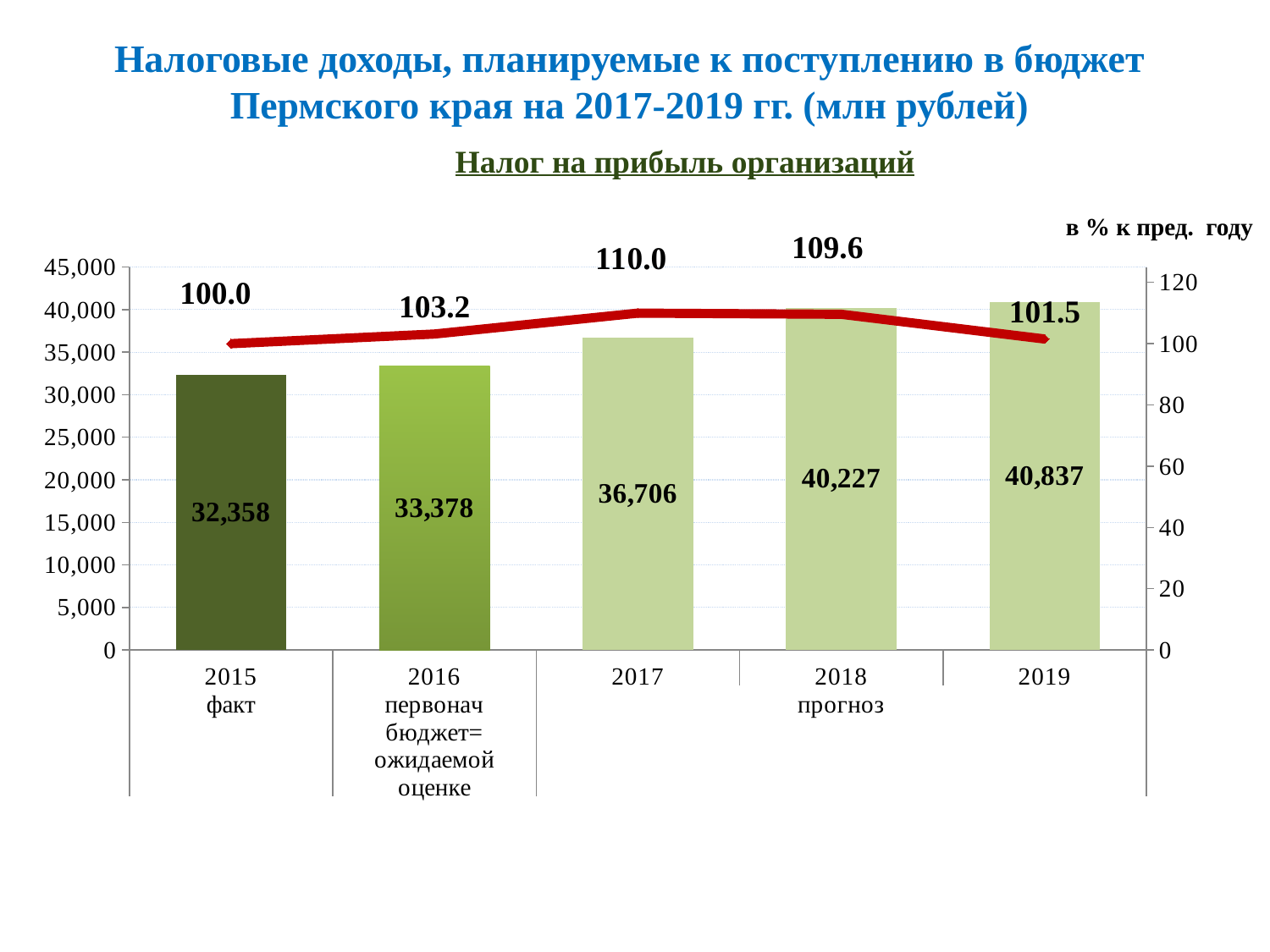
Do the bar values rise or fall from 2015 to 2019? rise What is the percentage to the previous year shown for 2018 on the line? 109.6 How many years (bars) are shown on the chart? 5 What is the difference between the bar values for 2016 and 2015? 1,020 Which year has the lowest bar value? 2015 What is the value of the bar for 2015? 32,358 Which year has the highest bar value? 2019 What is the difference between the bar values for 2019 and 2018? 610 What is the value of the bar for 2017? 36,706 Which year has the highest percentage to the previous year on the line? 2017 Which is larger, the bar value for 2017 or for 2016? 2017 What is the percentage to the previous year shown for 2019 on the line? 101.5